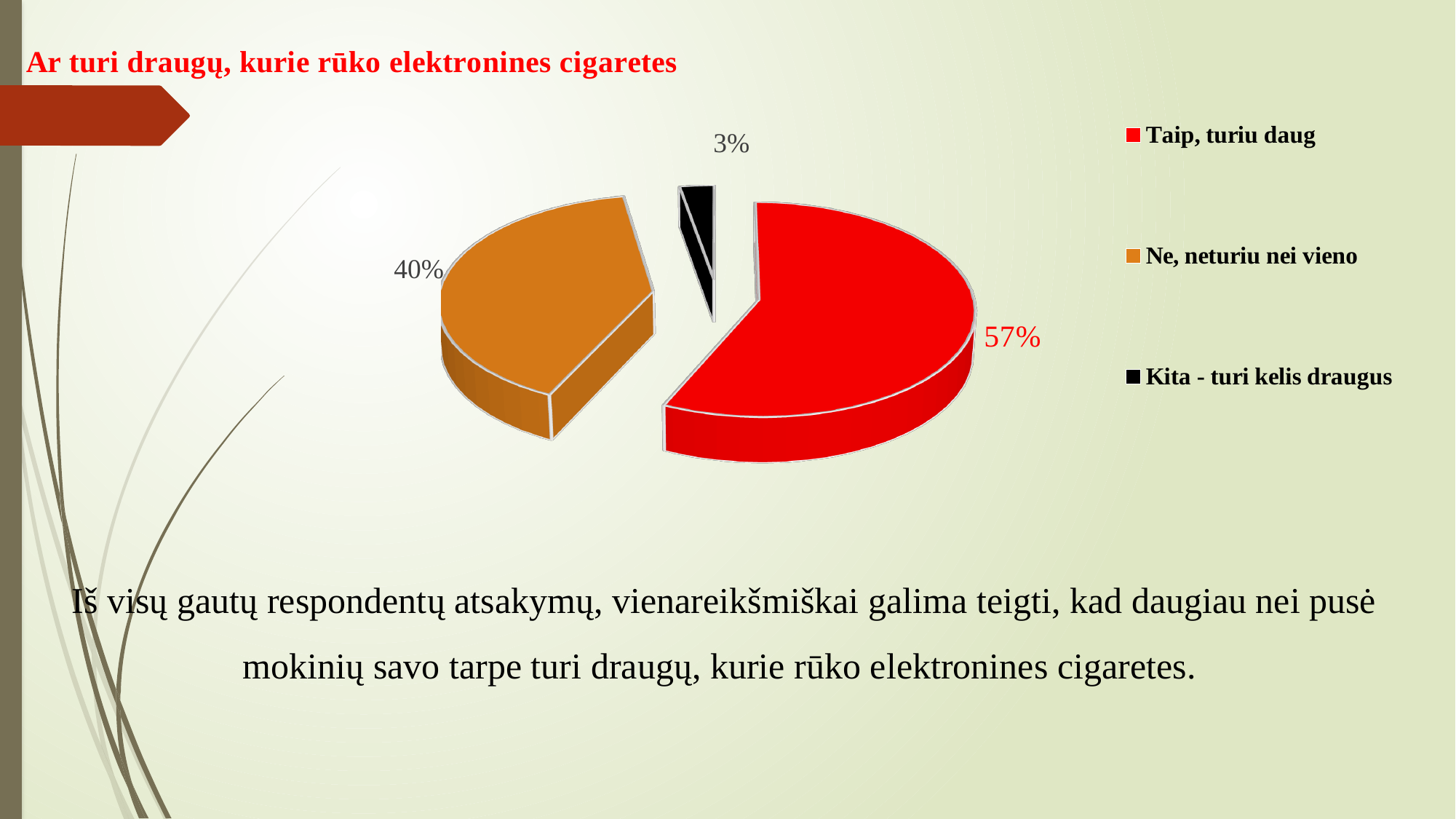
Which answer has the smallest share of the pie? Kita - turi kelis draugus Which is larger: the share for "Ne, neturiu nei vieno" or the share for "Kita - turi kelis draugus"? Ne, neturiu nei vieno How many slices does the pie chart have? 3 What percentage of respondents answered "Ne, neturiu nei vieno"? 40% Which answer has the largest share of the pie? Taip, turiu daug What percentage of respondents answered "Kita - turi kelis draugus"? 3% What percentage of respondents answered "Taip, turiu daug"? 57% What is the title of the chart? Ar turi draugų, kurie rūko elektronines cigaretes What kind of chart is shown on the slide? Pie chart What colour is the slice for "Ne, neturiu nei vieno"? Orange What is the difference in percentage points between "Taip, turiu daug" and "Ne, neturiu nei vieno"? 17 How many entries does the legend list? 3